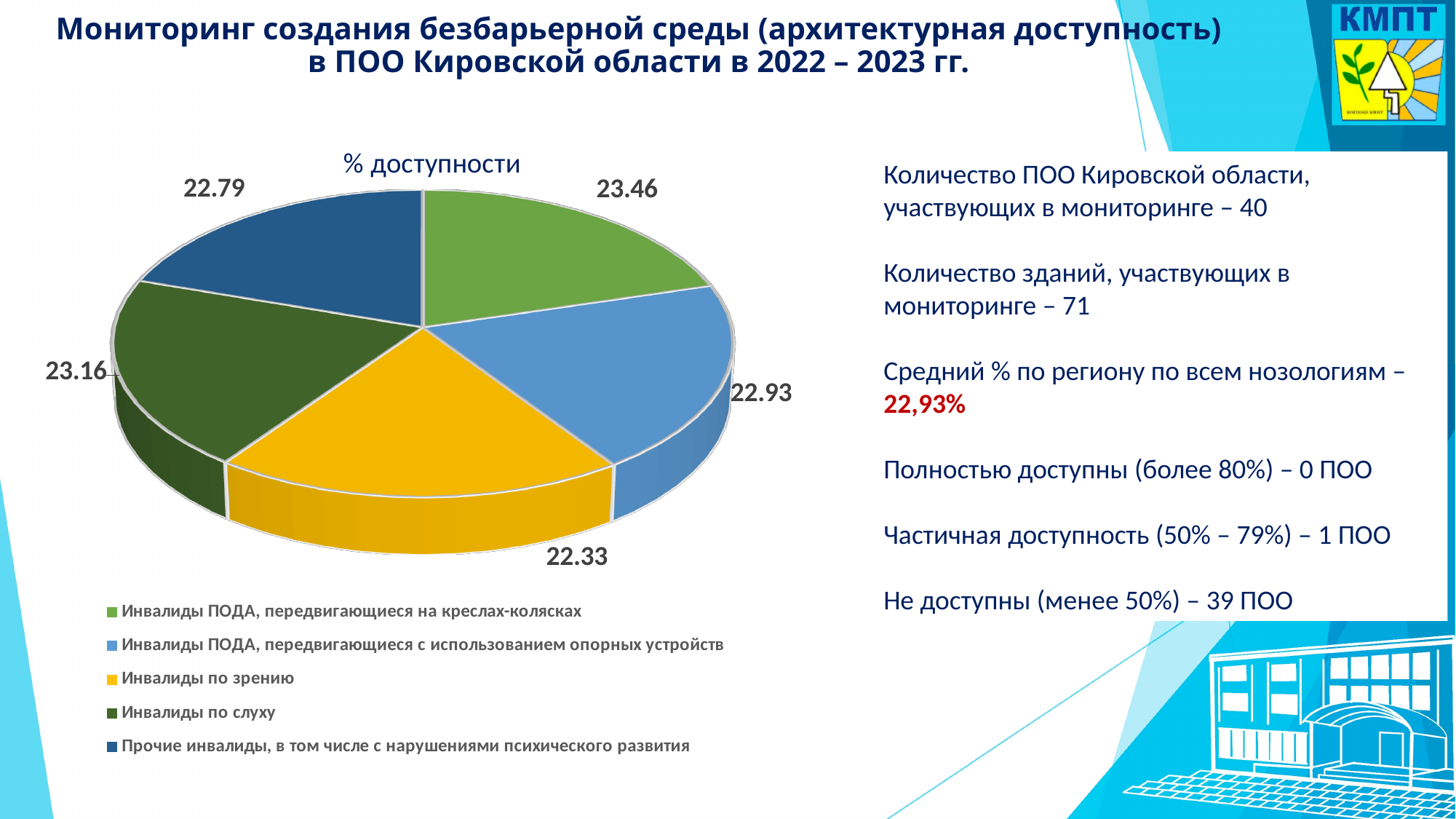
What kind of chart is shown on the slide? Pie chart Which is larger: the value for Инвалиды по слуху or the value for Прочие инвалиды, в том числе с нарушениями психического развития? Инвалиды по слуху Which category has the lowest value in the pie chart? Инвалиды по зрению How many slices does the pie chart have? 5 What is the title of the pie chart? % доступности What is the value for Инвалиды ПОДА, передвигающиеся с использованием опорных устройств? 22.93 What is the value for Инвалиды по слуху? 23.16 What is the value for Прочие инвалиды, в том числе с нарушениями психического развития? 22.79 What is the value for Инвалиды по зрению? 22.33 Which category has the highest value in the pie chart? Инвалиды ПОДА, передвигающиеся на креслах-колясках What is the difference between the values for Инвалиды ПОДА, передвигающиеся на креслах-колясках and Инвалиды по зрению? 1.13 What is the value for Инвалиды ПОДА, передвигающиеся на креслах-колясках? 23.46